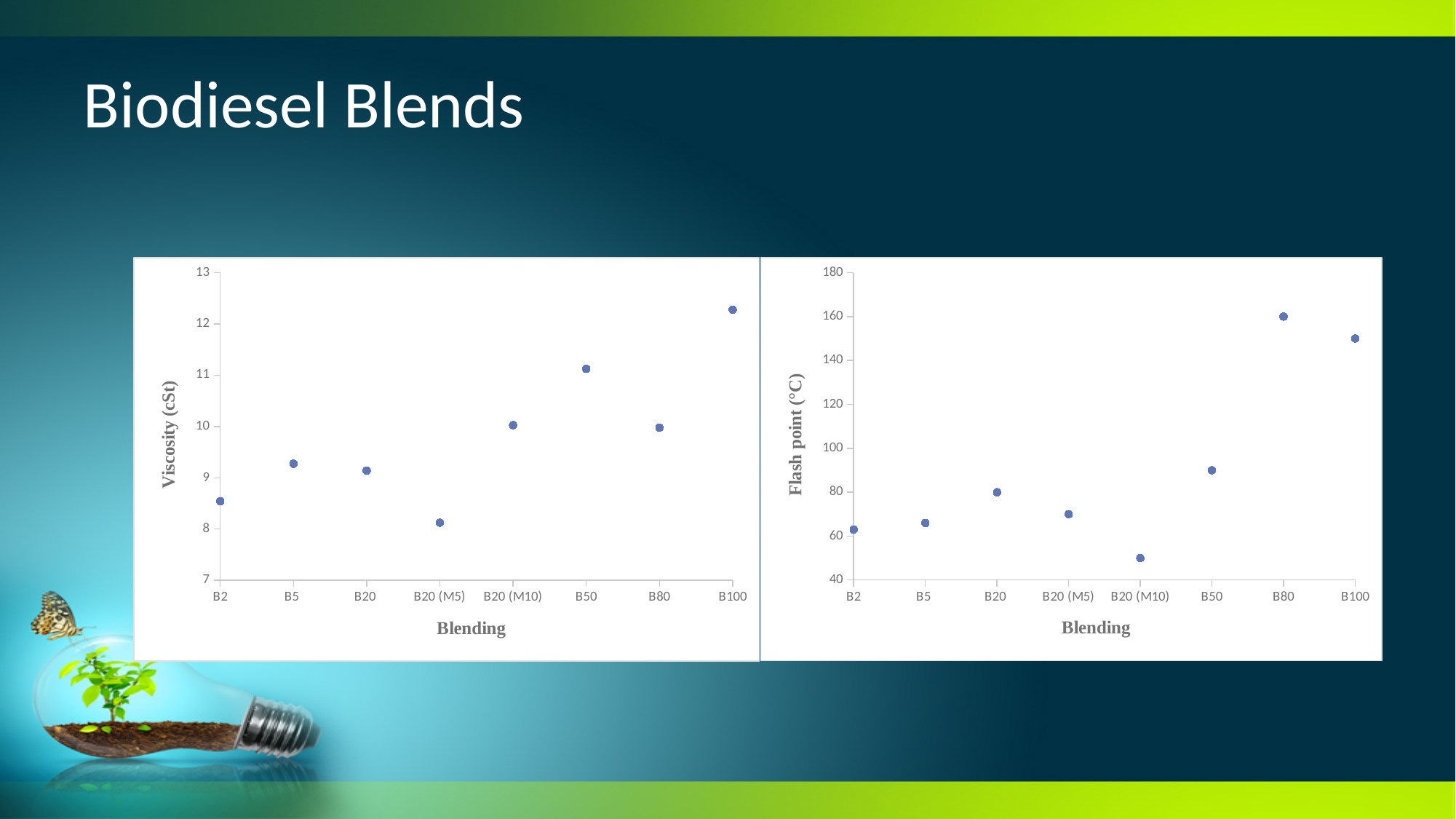
In the right chart (Flash point), is the value for B20 (M10) greater or less than 60? less In the left chart (Viscosity), is the value for B2 greater or less than 9? less In the left chart (Viscosity), which blend has the highest viscosity? B100 In the left chart (Viscosity), which blend has the lowest viscosity? B20 (M5) In the left chart (Viscosity), is the value for B100 greater or less than 12? greater In the right chart (Flash point), which blend has the highest flash point? B80 How many blends are plotted in the left chart (Viscosity)? 8 In the right chart (Flash point), which blend has the lowest flash point? B20 (M10) What kind of chart is the right chart (Flash point)? Scatter chart In the right chart (Flash point), which has the higher flash point, B80 or B100? B80 In the left chart (Viscosity), which has the higher viscosity, B50 or B80? B50